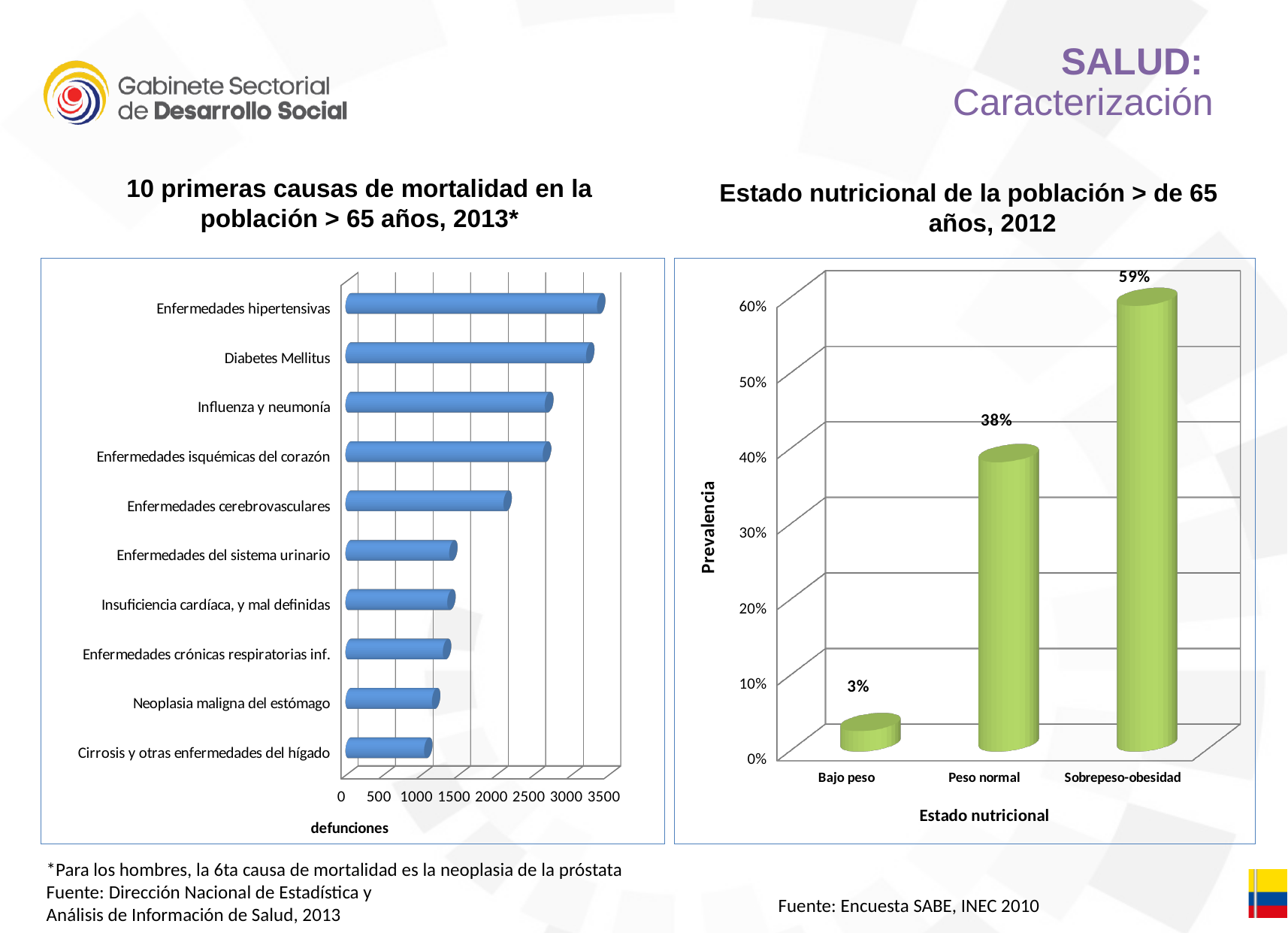
In the chart 'Estado nutricional de la población > de 65 años, 2012', what is the label of the y axis? Prevalencia In the chart 'Estado nutricional de la población > de 65 años, 2012', which category has the highest prevalence? Sobrepeso-obesidad In the chart '10 primeras causas de mortalidad en la población > 65 años, 2013*', how many causes of mortality are listed? 10 In the chart 'Estado nutricional de la población > de 65 años, 2012', what is the value for Sobrepeso-obesidad? 59% In the chart 'Estado nutricional de la población > de 65 años, 2012', how many categories are shown on the x axis? 3 In the chart '10 primeras causas de mortalidad en la población > 65 años, 2013*', is the value for Enfermedades hipertensivas greater or less than 3000? greater In the chart '10 primeras causas de mortalidad en la población > 65 años, 2013*', which cause has the most deaths? Enfermedades hipertensivas In the chart 'Estado nutricional de la población > de 65 años, 2012', what is the value for Bajo peso? 3% In the chart '10 primeras causas de mortalidad en la población > 65 años, 2013*', is the value for Influenza y neumonía greater or less than 3000? less In the chart '10 primeras causas de mortalidad en la población > 65 años, 2013*', what kind of chart is used? Bar chart In the chart 'Estado nutricional de la población > de 65 años, 2012', what is the difference between Sobrepeso-obesidad and Peso normal? 21% In the chart '10 primeras causas de mortalidad en la población > 65 años, 2013*', which has more deaths, Enfermedades cerebrovasculares or Enfermedades del sistema urinario? Enfermedades cerebrovasculares